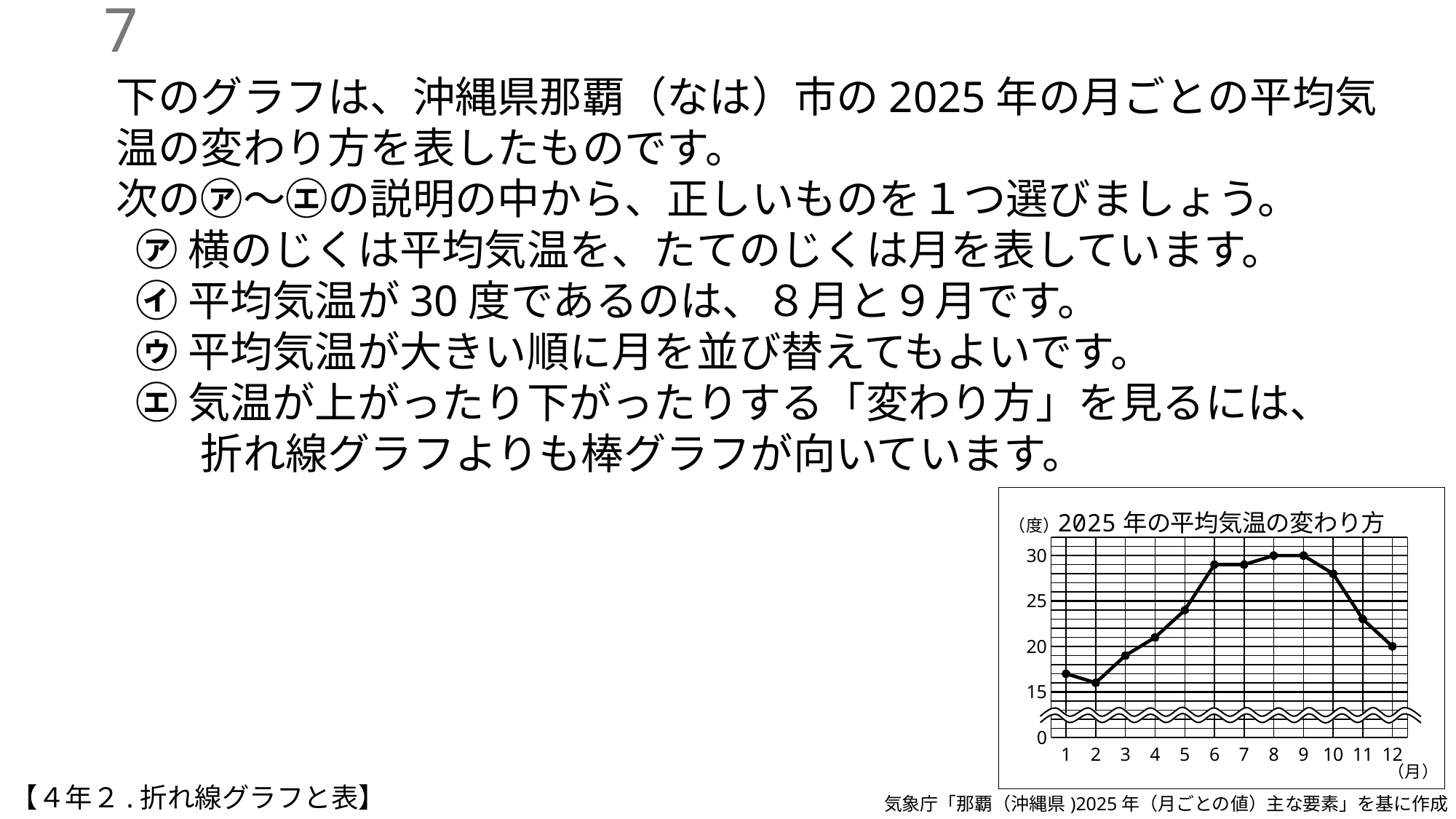
How many months are plotted on the chart? 12 What is the title of the chart? 2025年の平均気温の変わり方 Do the values rise or fall from month 9 to month 12? fall Which months have the highest average temperature? 8 and 9 What is the average temperature for month 12 (December)? 20 Which month has the lowest average temperature? 2 Is the value for month 6 greater or less than 25? greater What kind of chart is shown on the slide? line chart Is the value for month 11 greater or less than 25? less Is the value for month 2 greater or less than 20? less What is the average temperature for month 8 (August)? 30 Which is larger, the value for month 5 or the value for month 10? month 10